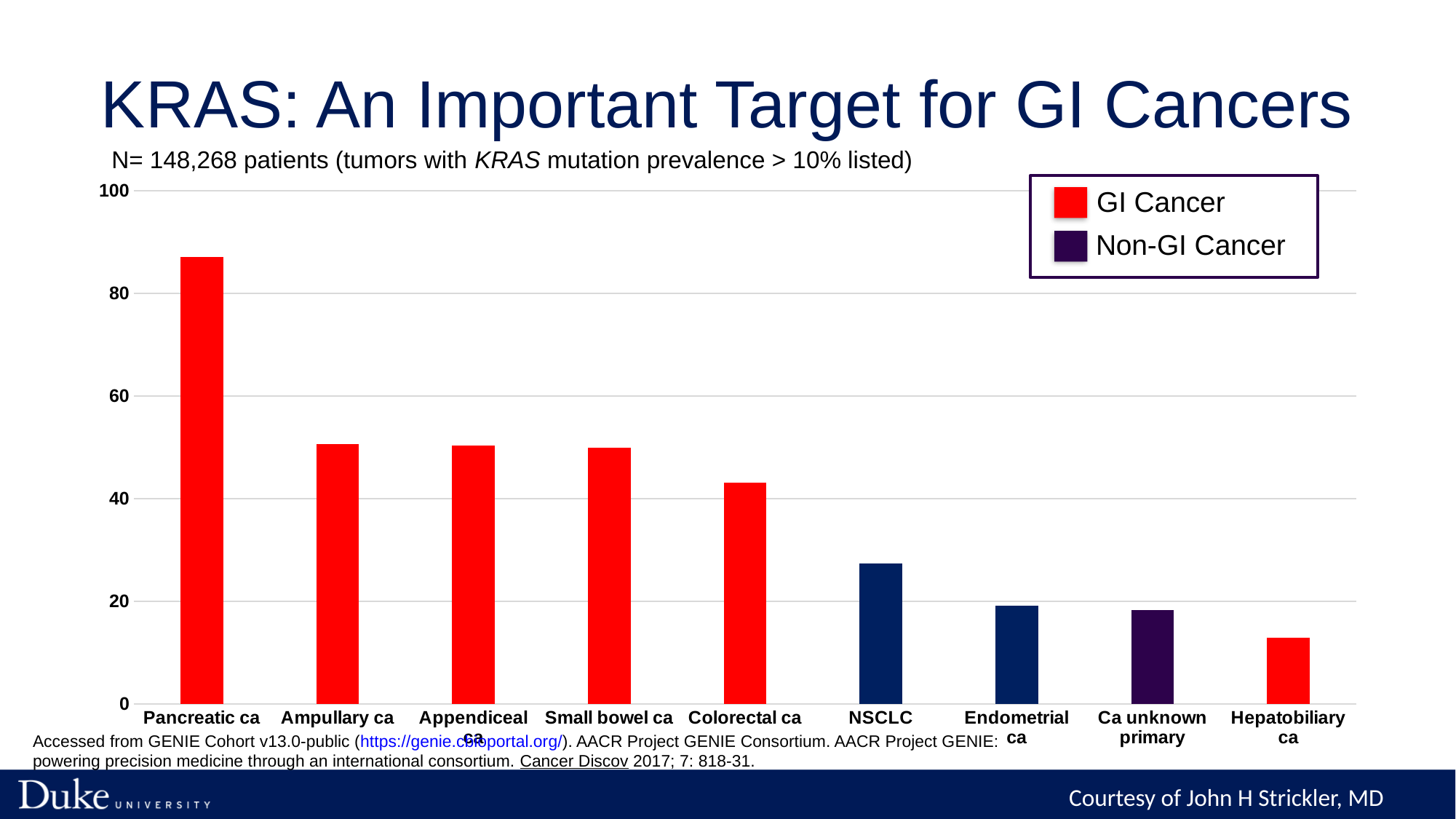
Which category has the highest bar? Pancreatic ca What kind of chart is shown on the slide? bar chart Which is larger, the value for Pancreatic ca or the value for Colorectal ca? Pancreatic ca Which legend entry is shown in red? GI Cancer Which category has the lowest bar? Hepatobiliary ca Is the value for Colorectal ca greater or less than 40? greater Is the value for Hepatobiliary ca greater or less than 20? less Is the value for NSCLC greater or less than 40? less How many categories are shown on the x axis? 9 Do the bar values generally rise or fall from left to right along the x axis? fall How many series does the legend list? 2